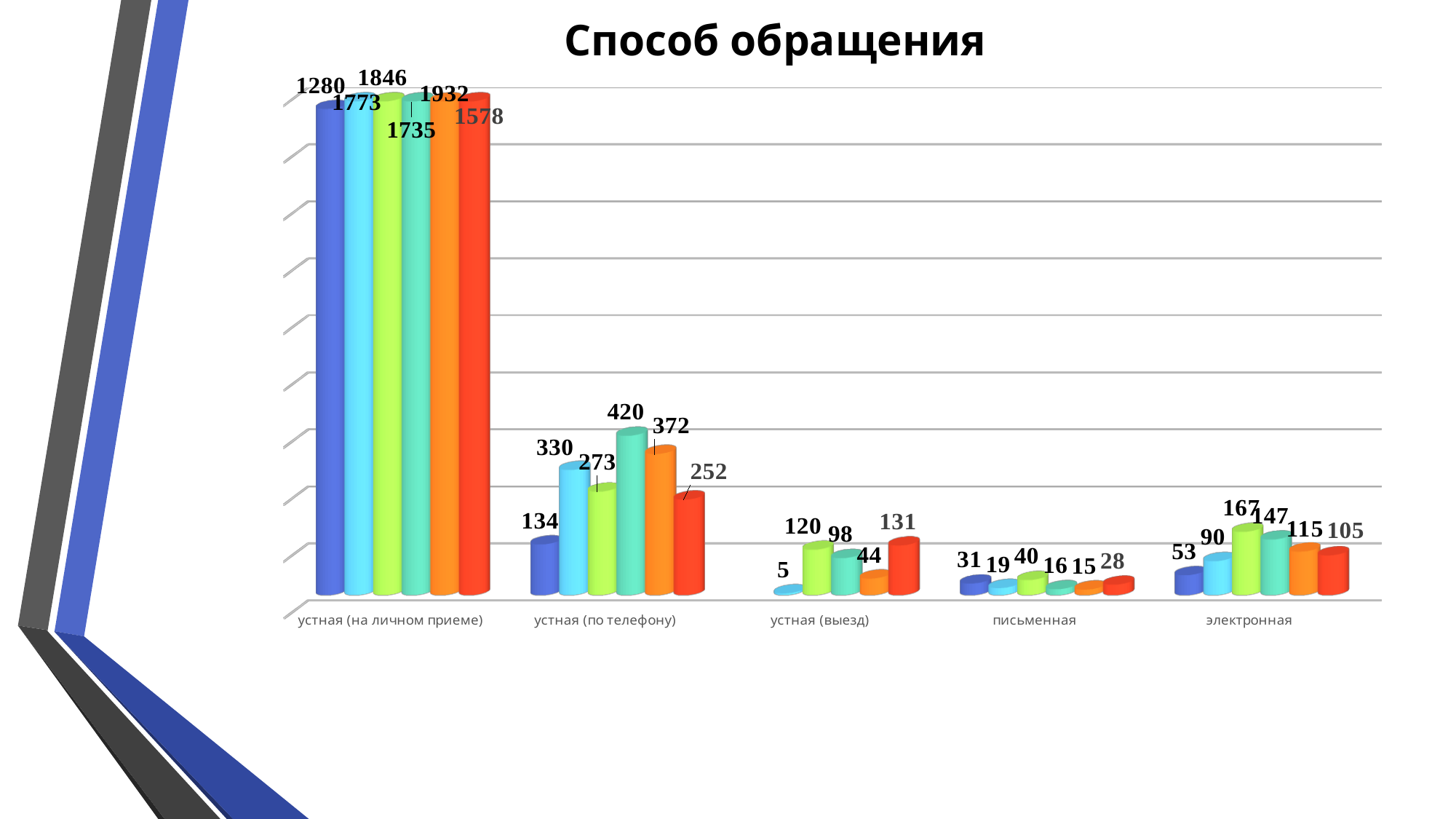
Which category has the highest values overall? устная (на личном приеме) What is the value of the blue bar for the category 'письменная'? 31 What kind of chart is shown on the slide? bar chart How many categories are shown on the x axis? 5 What is the difference between the green bar (167) and the blue bar (53) in the category 'электронная'? 114 What is the value of the red bar for the category 'электронная'? 105 Within the category 'устная (по телефону)', which bar has the highest value? the teal bar (420) What is the title of the chart? Способ обращения What is the value of the green bar for the category 'устная (по телефону)'? 273 Within the category 'письменная', which bar has the lowest value? the orange bar (15) In the category 'устная (выезд)', which is larger: the green bar or the red bar? the red bar (131) What is the value of the orange bar for the category 'устная (на личном приеме)'? 1932